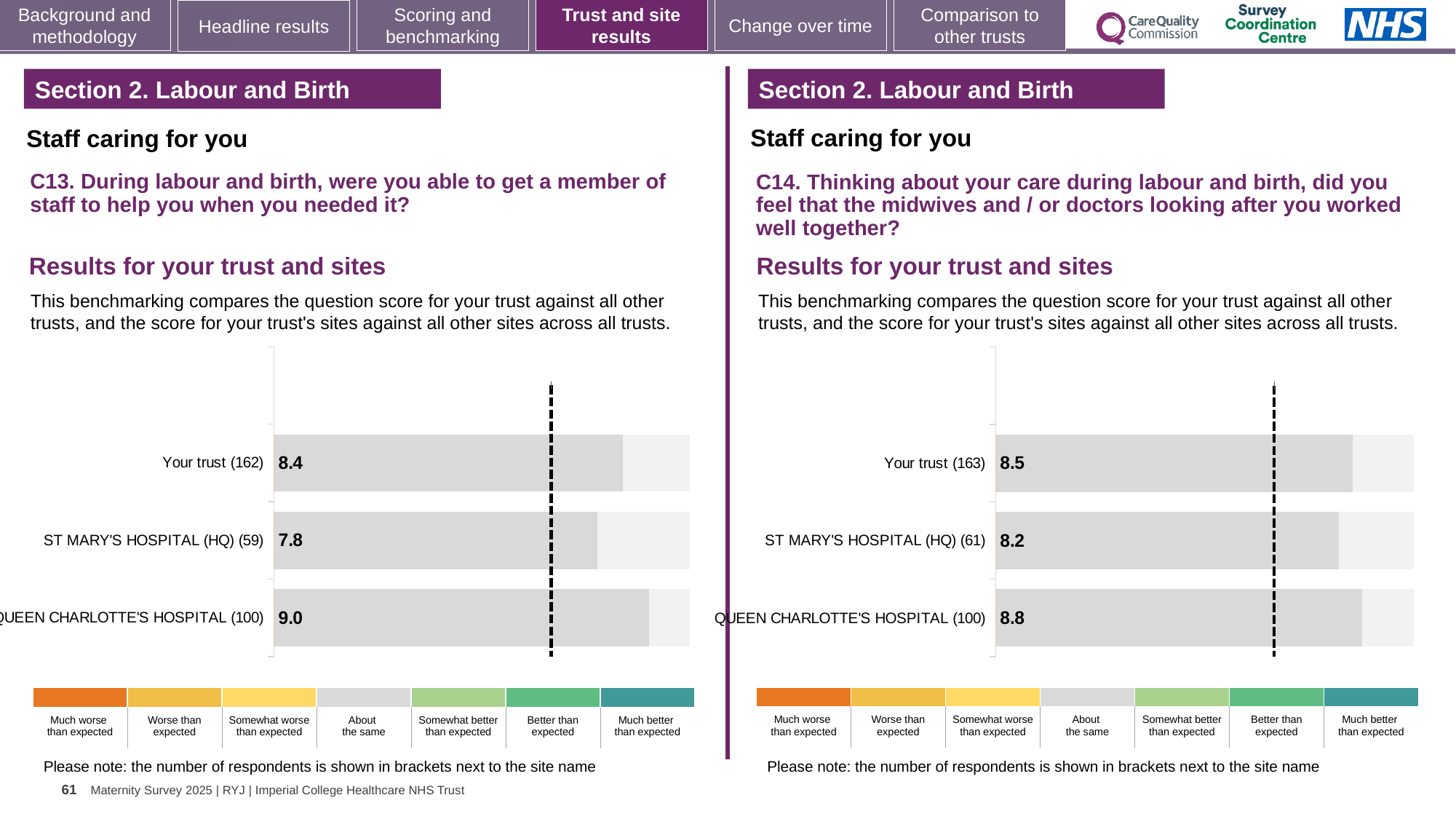
On the C14 chart (right), what is the score for ST MARY'S HOSPITAL (HQ) (61)? 8.2 How many bars are shown on the C13 chart (left)? 3 On the C13 chart (left), what is the difference between the scores for QUEEN CHARLOTTE'S HOSPITAL (100) and ST MARY'S HOSPITAL (HQ) (59)? 1.2 On the C14 chart (right), which is larger, the score for Your trust (163) or for QUEEN CHARLOTTE'S HOSPITAL (100)? QUEEN CHARLOTTE'S HOSPITAL (100) On the C14 chart (right), which site or trust has the lowest score? ST MARY'S HOSPITAL (HQ) (61) On the C13 chart (left), which site or trust has the highest score? QUEEN CHARLOTTE'S HOSPITAL (100) On the C13 chart (left), what is the score for ST MARY'S HOSPITAL (HQ) (59)? 7.8 On the C13 chart (left), which site or trust has the lowest score? ST MARY'S HOSPITAL (HQ) (59) On the C14 chart (right), what is the score for QUEEN CHARLOTTE'S HOSPITAL (100)? 8.8 What kind of chart is the C14 chart (right)? Bar chart On the C14 chart (right), what is the difference between the scores for Your trust (163) and ST MARY'S HOSPITAL (HQ) (61)? 0.3 On the C13 chart (left), what is the score for Your trust (162)? 8.4